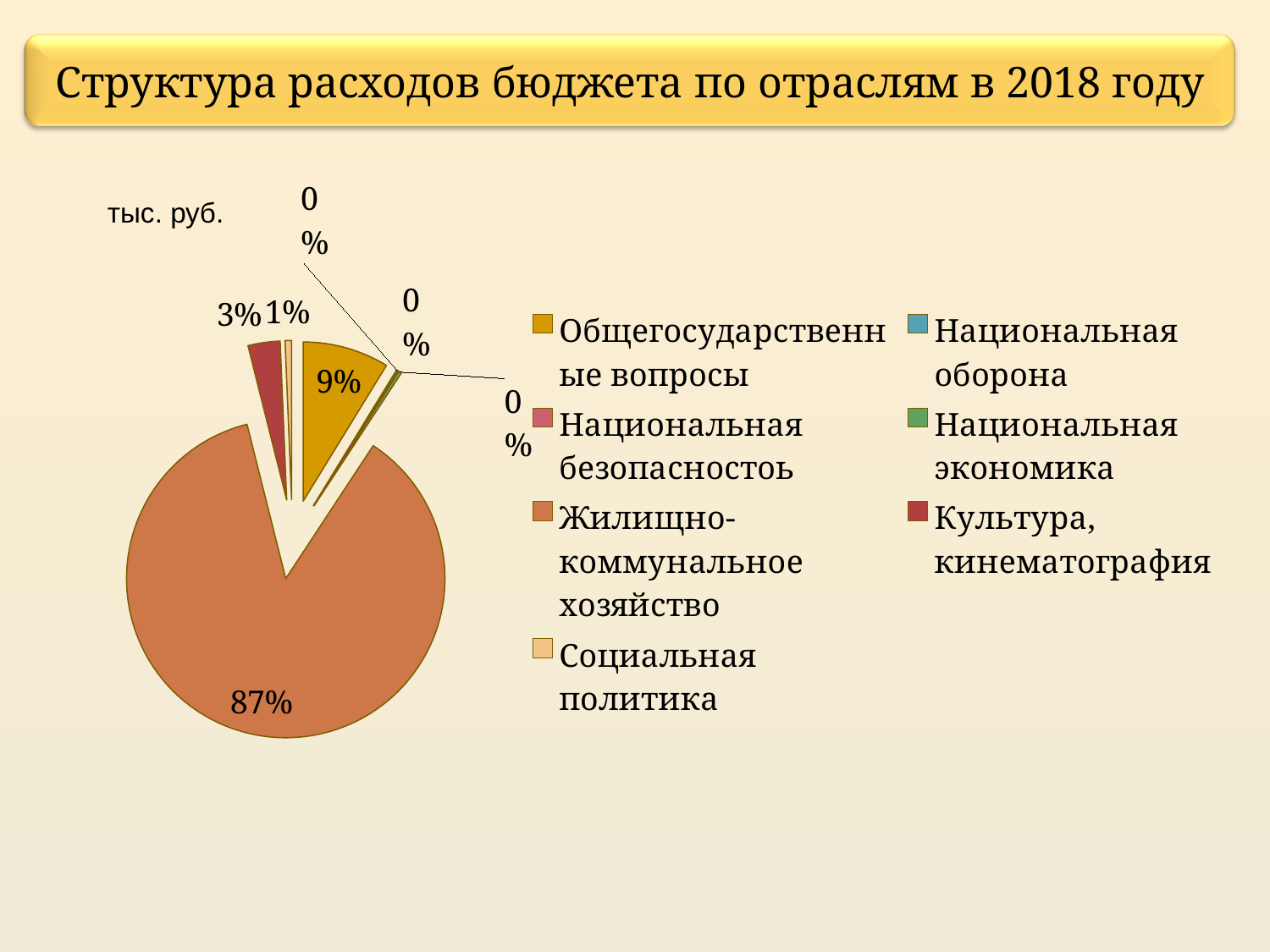
What share of the pie does Общегосударственные вопросы have? 9% How many slices are labelled 0%? 3 What kind of chart is shown on the slide? pie chart What unit label is shown above the pie chart? тыс. руб. What share of the pie does Жилищно-коммунальное хозяйство have? 87% By how many percentage points does the share of Жилищно-коммунальное хозяйство exceed the share of Общегосударственные вопросы? 78 percentage points Which is larger: the share for Общегосударственные вопросы or the share for Культура, кинематография? Общегосударственные вопросы Which category has the largest slice of the pie? Жилищно-коммунальное хозяйство What is the title of the slide? Структура расходов бюджета по отраслям в 2018 году How many categories does the legend list? 7 What share of the pie does Социальная политика have? 1%